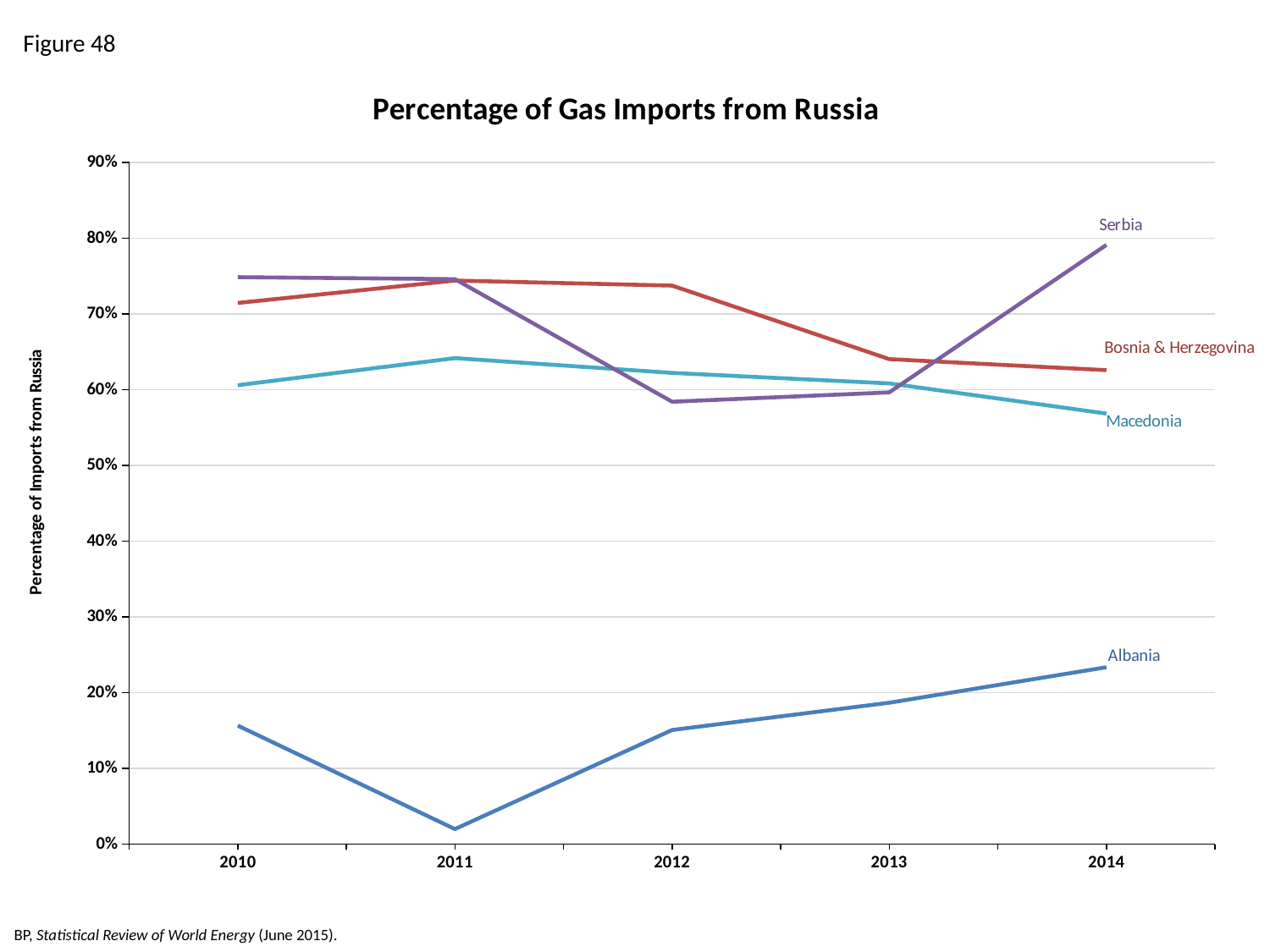
In which year is Serbia's value highest? 2014 In 2012, which is larger: the value for Bosnia & Herzegovina or the value for Serbia? Bosnia & Herzegovina Which country has the lowest percentage of gas imports from Russia in 2014? Albania How many countries are plotted as lines on the chart? 4 How many years are plotted along the x axis? 5 Which country has the highest percentage of gas imports from Russia in 2014? Serbia Is the value for Serbia in 2014 greater or less than 70%? greater What kind of chart is shown on the slide? line chart What is the title of the chart? Percentage of Gas Imports from Russia Is the value for Albania in 2011 greater or less than 10%? less In which year is Albania's value lowest? 2011 Does Albania's value rise or fall from 2011 to 2014? rise